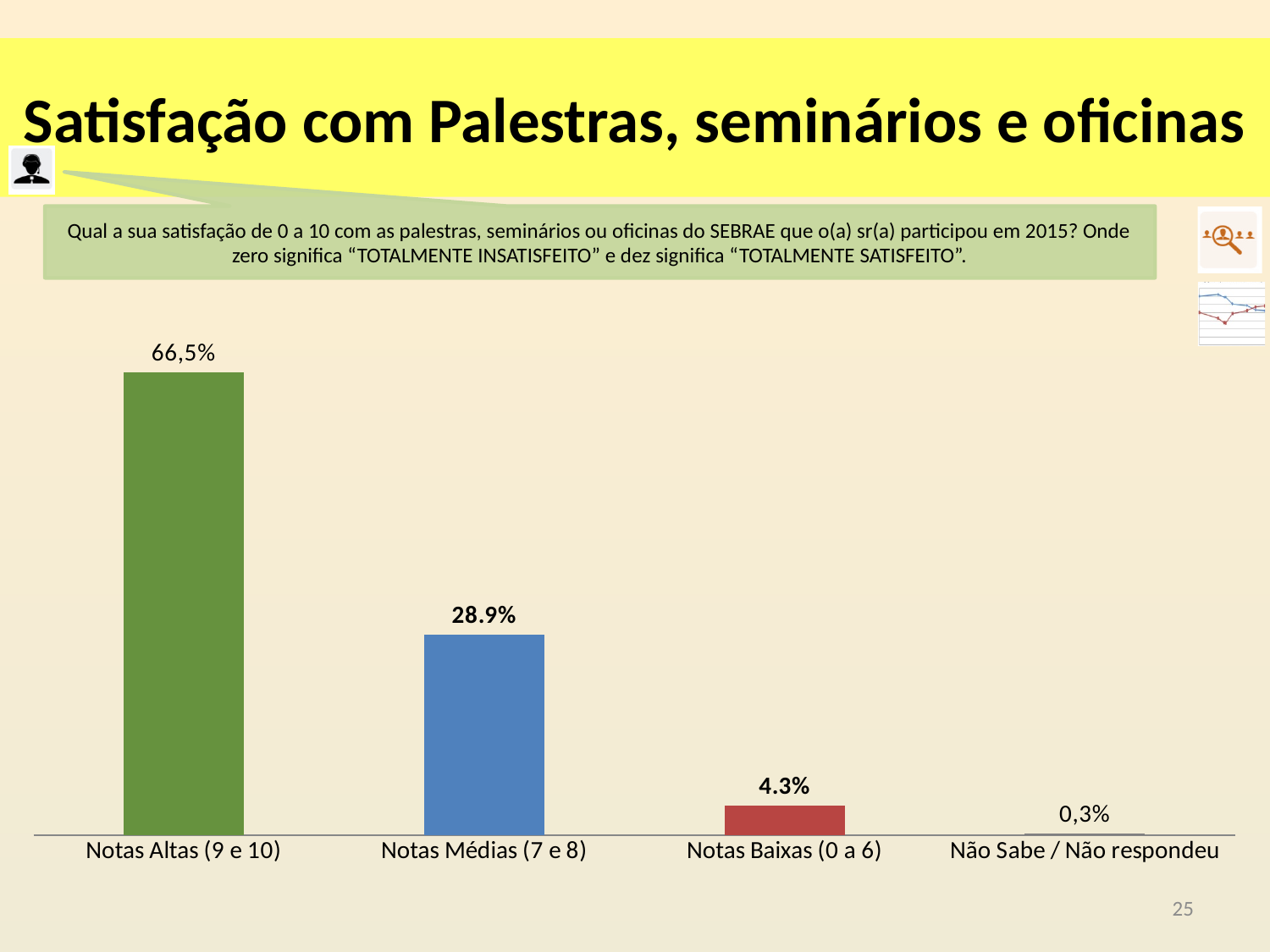
What is the value for Notas Altas (9 e 10)? 66,5% What is the value for Notas Baixas (0 a 6)? 4.3% Which category has the highest value? Notas Altas (9 e 10) Which is larger, the value for Notas Médias (7 e 8) or the value for Notas Baixas (0 a 6)? Notas Médias (7 e 8) How many categories are shown in the chart? 4 Do the values rise or fall from left to right across the categories? Fall What is the value for Não Sabe / Não respondeu? 0,3% What kind of chart is shown on the slide? Bar chart What is the difference between the values for Notas Médias (7 e 8) and Notas Baixas (0 a 6)? 24.6% Which category has the lowest value? Não Sabe / Não respondeu What is the difference between the values for Notas Altas (9 e 10) and Não Sabe / Não respondeu? 66,2% What is the value for Notas Médias (7 e 8)? 28.9%